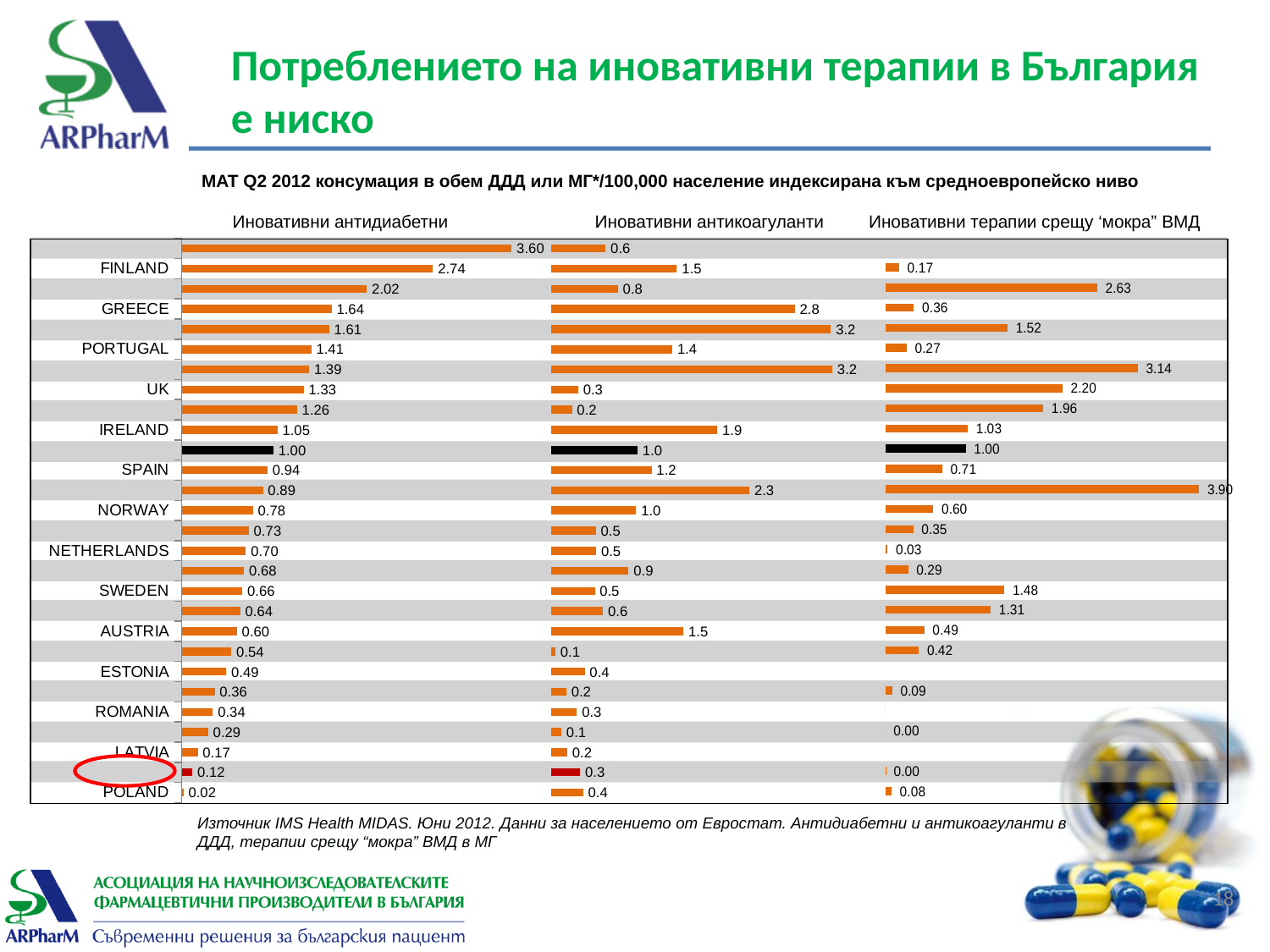
In the 'Иновативни терапии срещу 'мокра' ВМД' chart, what is the value for NETHERLANDS? 0.03 In the 'Иновативни антидиабетни' chart, which country has the lowest value? POLAND In the 'Иновативни антидиабетни' chart, what is the value for POLAND? 0.02 In the 'Иновативни терапии срещу 'мокра' ВМД' chart, what is the difference between the values for SWEDEN and AUSTRIA? 0.99 In the 'Иновативни антидиабетни' chart, what is the value for FINLAND? 2.74 How many charts are shown on the slide? 3 What kind of chart is used on this slide? Bar chart In the 'Иновативни антикоагуланти' chart, what is the value for AUSTRIA? 1.5 In the 'Иновативни терапии срещу 'мокра' ВМД' chart, what is the value for UK? 2.20 In the 'Иновативни антикоагуланти' chart, what is the value for GREECE? 2.8 In the 'Иновативни антикоагуланти' chart, which has the larger value, IRELAND or SPAIN? IRELAND In the 'Иновативни антидиабетни' chart, what is the difference between the values for FINLAND and GREECE? 1.10